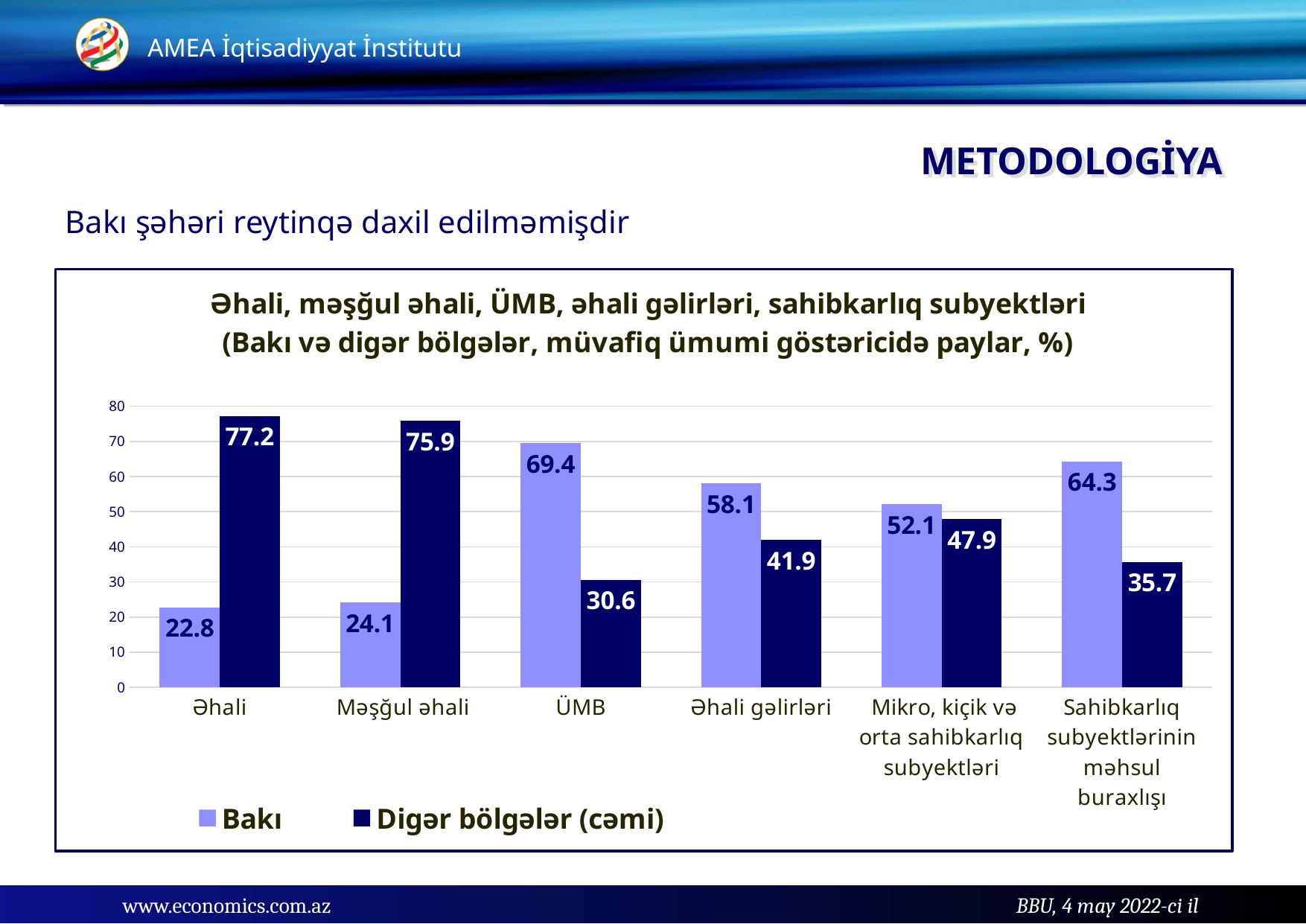
How many categories are shown on the x axis? 6 What is the value for Digər bölgələr (cəmi) in the Məşğul əhali category? 75.9 In the Mikro, kiçik və orta sahibkarlıq subyektləri category, which series has the larger value, Bakı or Digər bölgələr (cəmi)? Bakı Which series is shown in dark navy blue in the legend? Digər bölgələr (cəmi) Which category has the lowest value for Digər bölgələr (cəmi)? ÜMB What is the value for Bakı in the ÜMB category? 69.4 What is the value for Digər bölgələr (cəmi) in the Sahibkarlıq subyektlərinin məhsul buraxlışı category? 35.7 What is the difference between the Digər bölgələr (cəmi) and Bakı values in the Əhali gəlirləri category? 16.2 What is the value for Bakı in the Əhali category? 22.8 Which category has the highest value for Bakı? ÜMB How many series does the legend list? 2 What kind of chart is shown on the slide? Bar chart